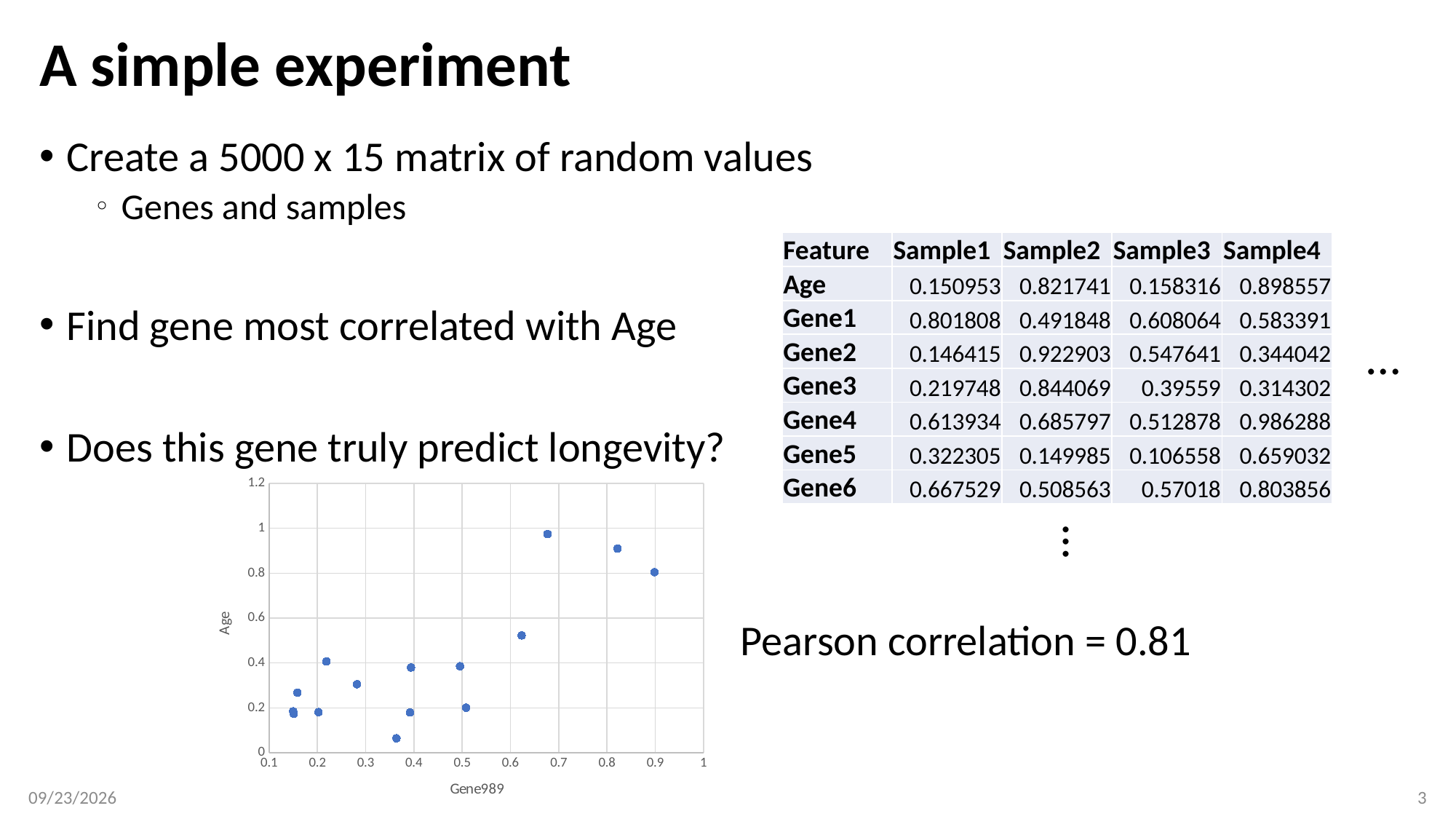
What is the label of the y axis of the scatter chart? Age What is the maximum value shown on the y axis of the scatter chart? 1.2 What kind of chart is shown on the slide? scatter chart Is the Age value of the highest point in the scatter chart greater or less than 0.8? greater Is the largest Gene989 value plotted in the scatter chart greater or less than 0.8? greater In the scatter chart, do the Age values generally rise or fall as Gene989 increases? rise Is the Age value of the point with the largest Gene989 value greater or less than 0.6? greater What is the label of the x axis of the scatter chart? Gene989